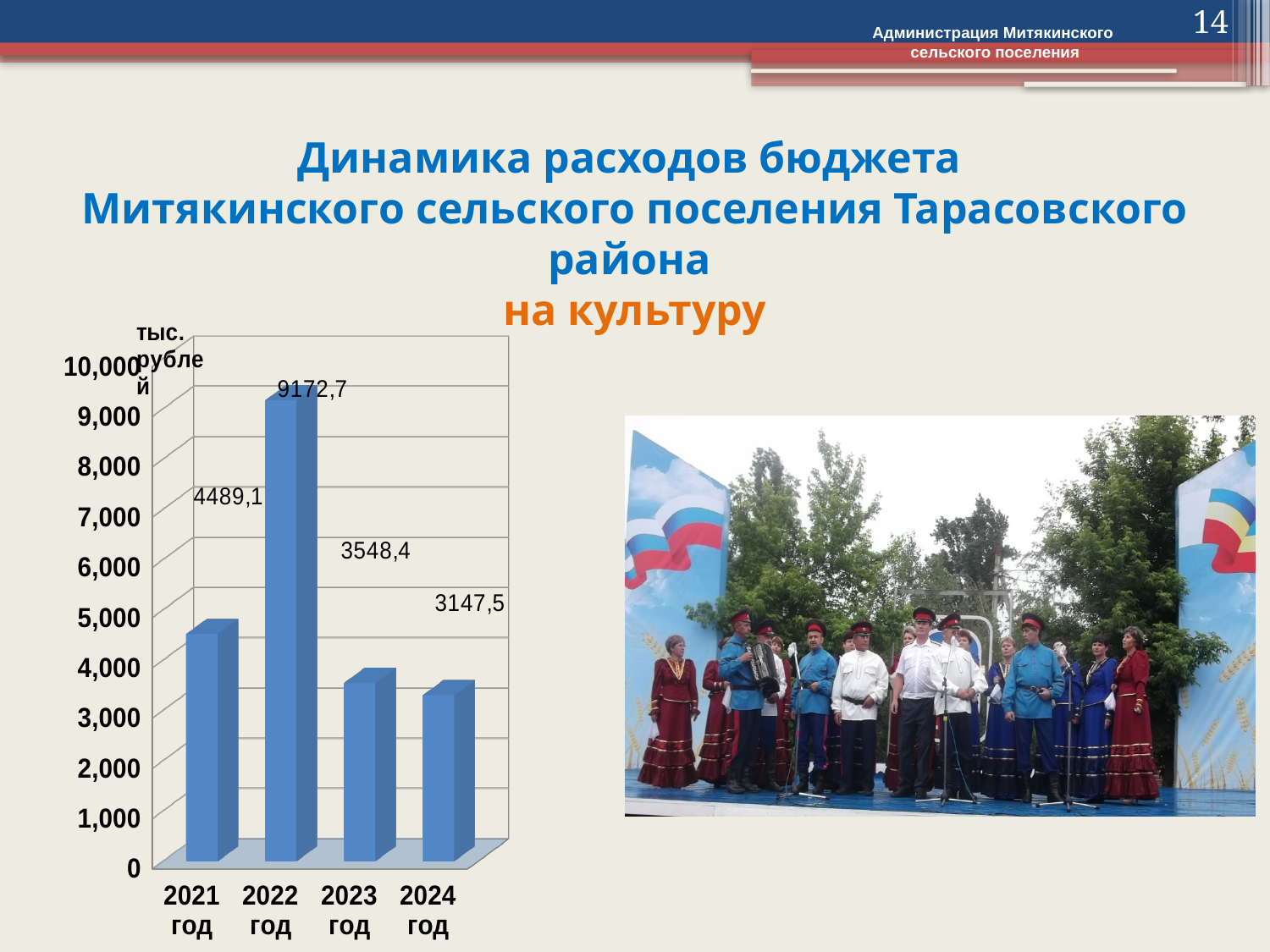
What is the value for 2021 год? 4489,1 Which year has the highest value? 2022 год What is the difference between the values for 2023 год and 2024 год? 400,9 How many years are shown on the chart? 4 What is the value for 2022 год? 9172,7 What kind of chart is shown on the slide? bar chart What is the difference between the values for 2022 год and 2021 год? 4683,6 Which year has the lowest value? 2024 год What unit is indicated on the chart's vertical axis? тыс. рублей Which is larger, the value for 2021 год or the value for 2023 год? 2021 год What is the value for 2024 год? 3147,5 What is the value for 2023 год? 3548,4